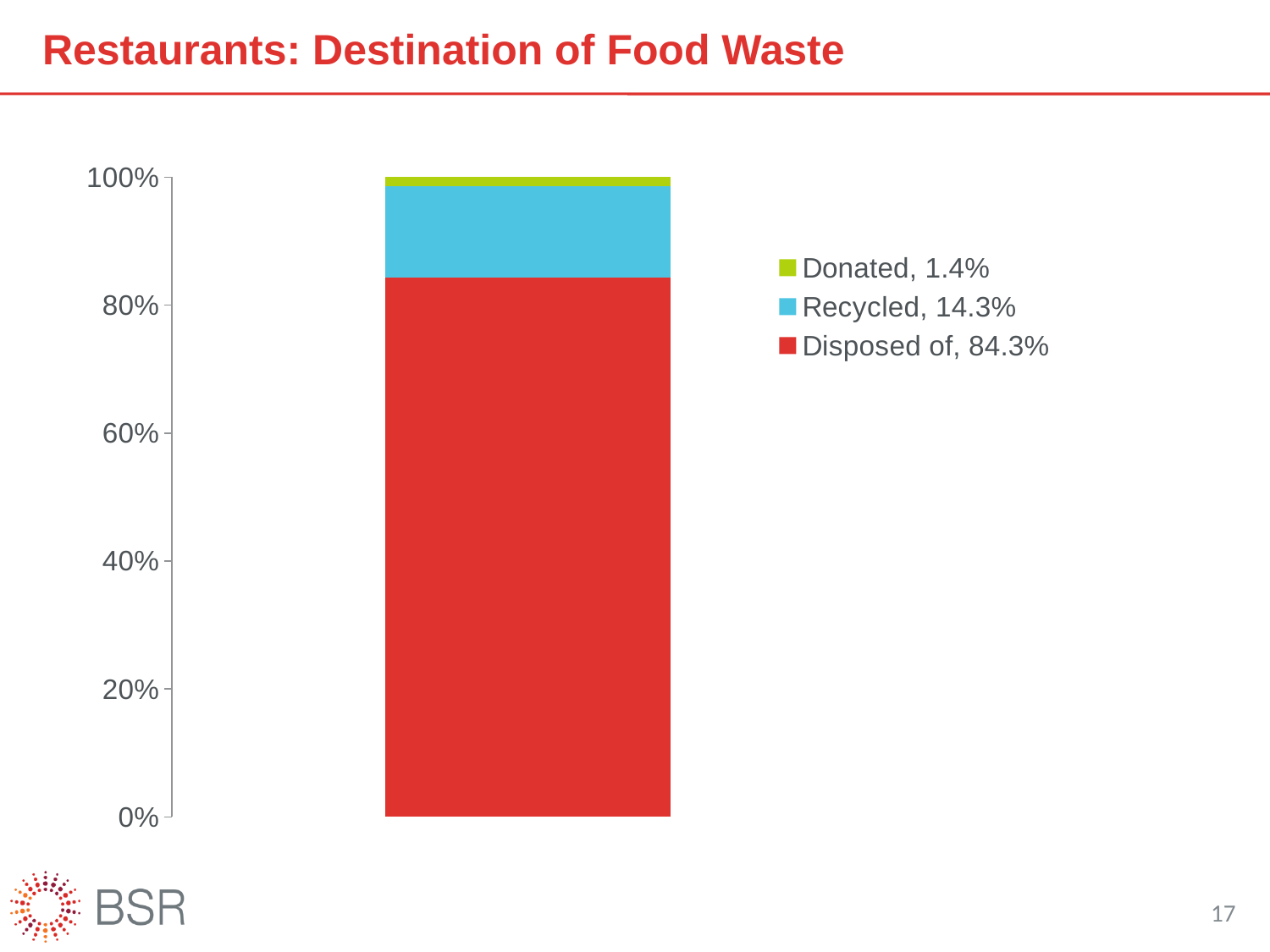
What kind of chart is shown on the slide? Stacked bar chart What percentage of restaurant food waste is disposed of? 84.3% How many percentage points higher is the Recycled share than the Donated share? 12.9 percentage points How many series does the legend list? 3 Which destination accounts for the smallest share of restaurant food waste? Donated What percentage of restaurant food waste is donated? 1.4% Which destination accounts for the largest share of restaurant food waste? Disposed of How many percentage points higher is the Disposed of share than the Recycled share? 70.0 percentage points What colour represents the Recycled segment in the chart? Blue Is the Disposed of share greater or less than 80%? greater Which is larger, the share of food waste that is recycled or the share that is donated? Recycled What percentage of restaurant food waste is recycled? 14.3%